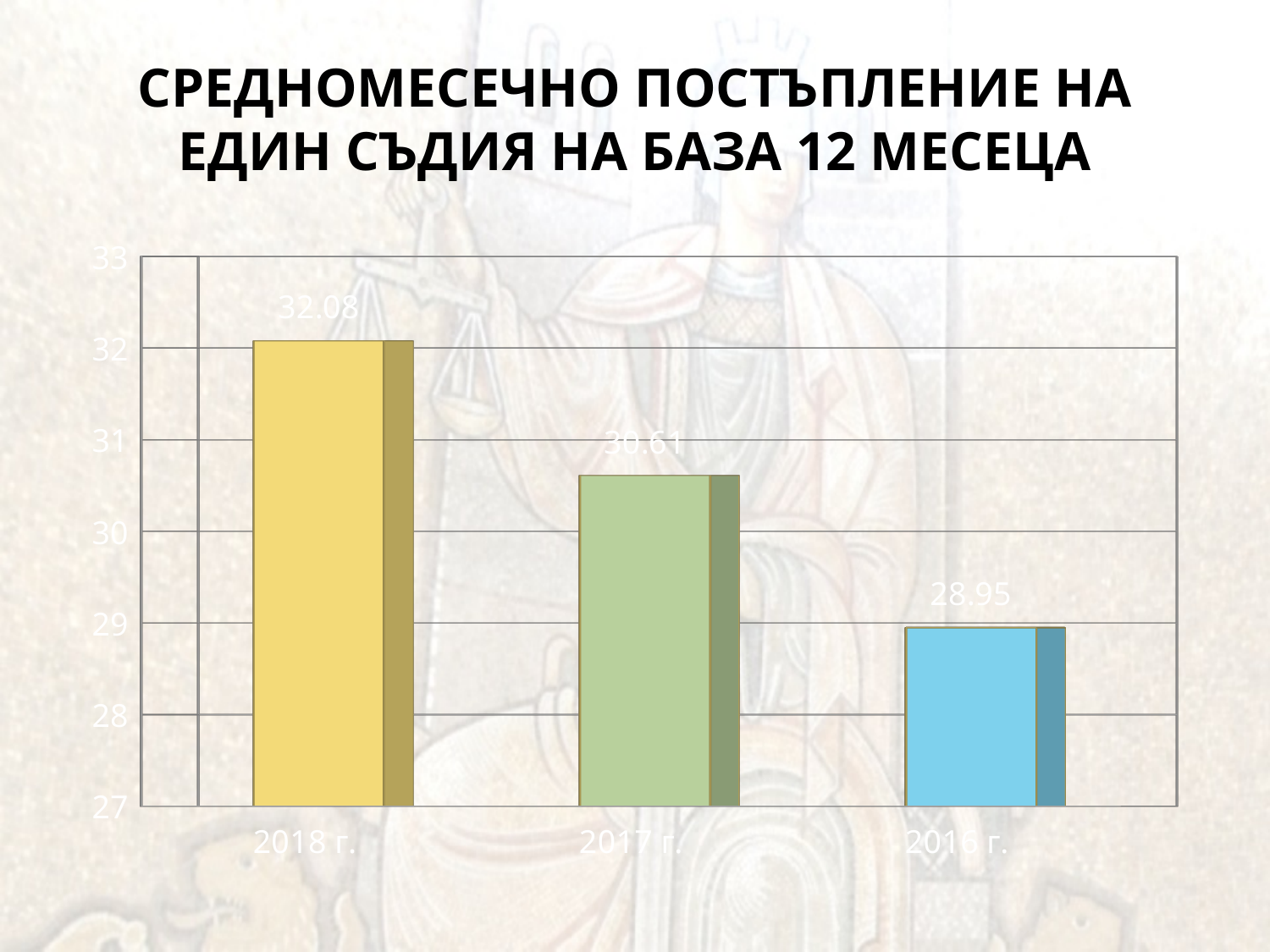
What is the difference between the values for 2018 г. and 2017 г.? 1.47 How many categories are shown on the chart? 3 Is the value for 2017 г. greater or less than 31? less What kind of chart is shown on the slide? bar chart Which year has the lowest value? 2016 г. What is the value for 2018 г.? 32.08 What is the value for 2016 г.? 28.95 What is the difference between the values for 2018 г. and 2016 г.? 3.13 Which year has the highest value? 2018 г. Do the values rise or fall from left to right along the x axis? fall What is the value for 2017 г.? 30.61 Which is larger, the value for 2017 г. or the value for 2016 г.? 2017 г.